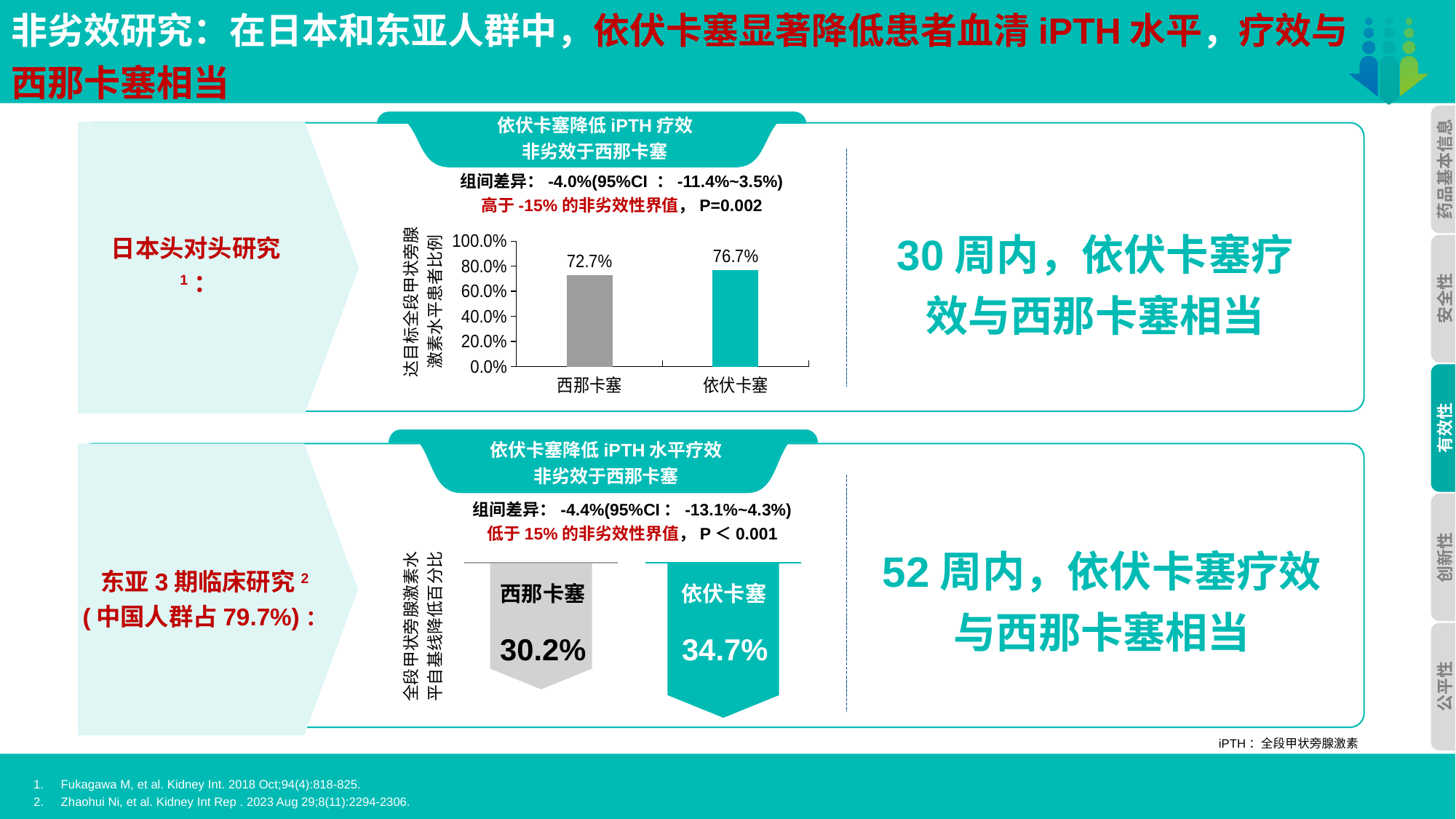
How many categories are shown in the top bar chart (日本头对头研究)? 2 What kind of chart is the top chart (日本头对头研究)? bar chart In the top bar chart (日本头对头研究), which category has the highest value? 依伏卡塞 In the top bar chart (日本头对头研究), what colour is the bar for 依伏卡塞? teal In the top bar chart (日本头对头研究), what is the maximum value shown on the y axis? 100.0% In the top bar chart (日本头对头研究), which category has the lowest value? 西那卡塞 In the top bar chart (日本头对头研究), what is the value for 依伏卡塞? 76.7% In the top bar chart (日本头对头研究), is the value for 西那卡塞 greater or less than 80.0%? less In the bottom graphic (东亚3期临床研究), what is the value shown for 西那卡塞? 30.2% In the top bar chart (日本头对头研究), what is the difference between the values for 依伏卡塞 and 西那卡塞? 4.0% In the bottom graphic (东亚3期临床研究), what is the value shown for 依伏卡塞? 34.7% In the top bar chart (日本头对头研究), what is the value for 西那卡塞? 72.7%